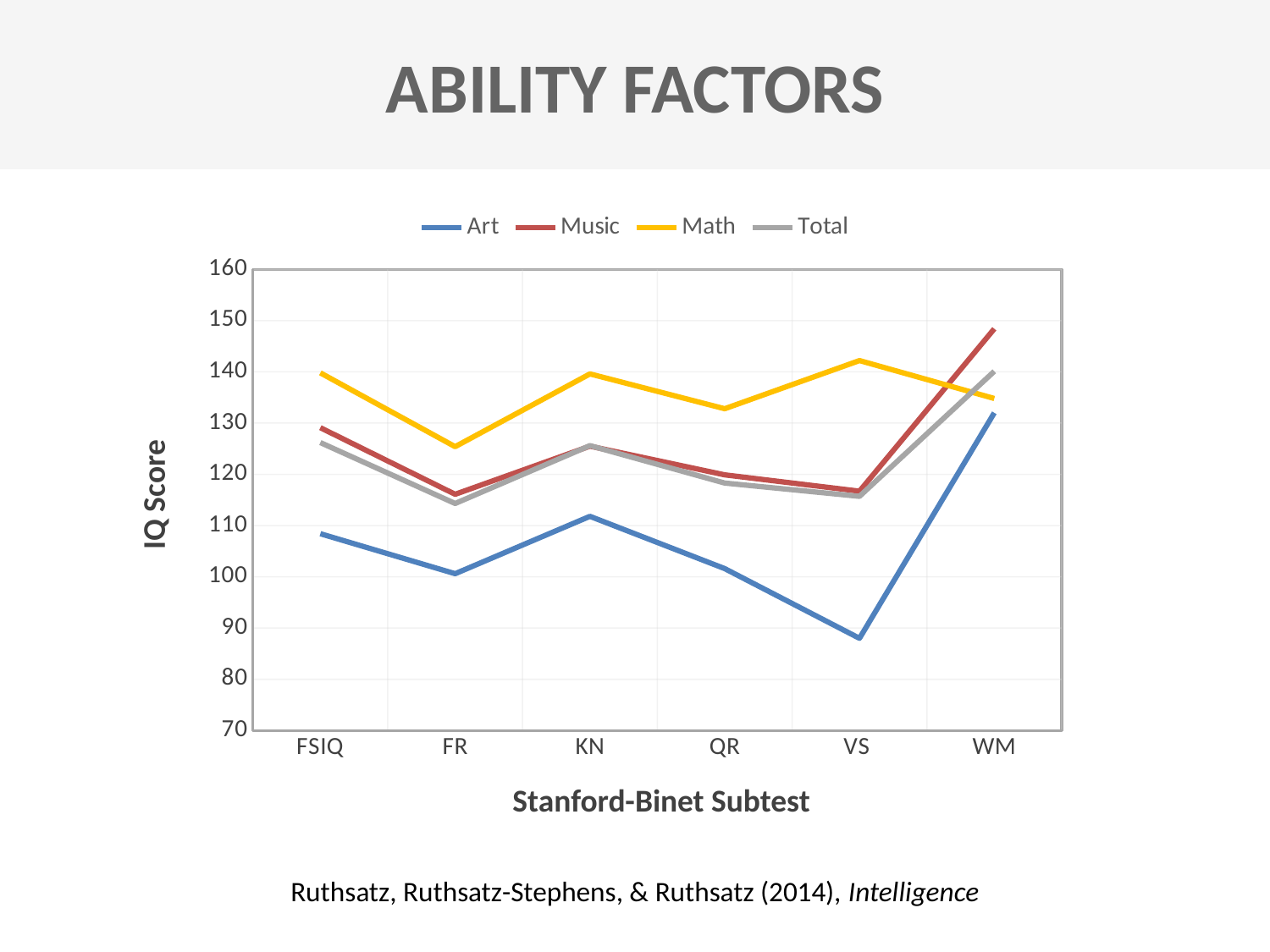
For which subtest is the Total series highest? WM Is the Music value for WM greater or less than 140? greater How many subtests are shown along the x axis? 6 At WM, which series has the higher value, Music or Math? Music For which subtest is the Music series highest? WM What kind of chart is shown on the slide? line chart At FSIQ, which series has the higher value, Math or Art? Math How many series does the legend list? 4 Is the Math value for FR greater or less than 120? greater Is the Art value for VS greater or less than 100? less For which subtest is the Art series lowest? VS Does the Art series rise or fall from QR to VS? fall